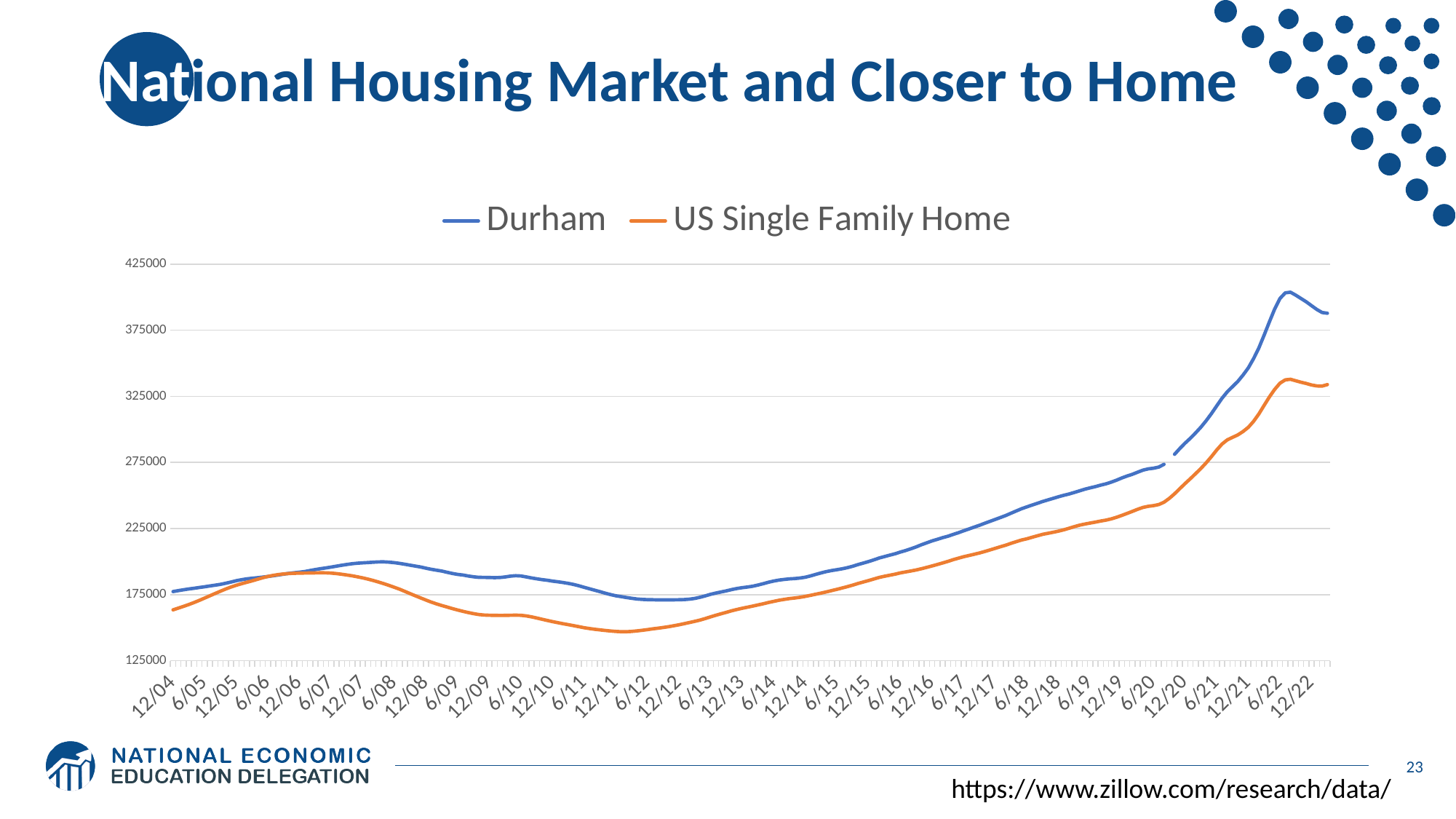
What are the two series named in the legend? Durham and US Single Family Home Does the Durham line rise or fall between 6/20 and 6/22? rise Which series is drawn in orange? US Single Family Home At 12/22, which series has the higher value, Durham or US Single Family Home? Durham At 6/08, which series has the higher value, Durham or US Single Family Home? Durham Is the value for Durham at 6/21 greater or less than 275000? greater How many series does the legend list? 2 What kind of chart is shown on the slide? line chart Does the US Single Family Home line rise or fall between 12/06 and 6/11? fall Is the value for Durham at 6/22 greater or less than 375000? greater Is the value for US Single Family Home at 6/11 greater or less than 175000? less